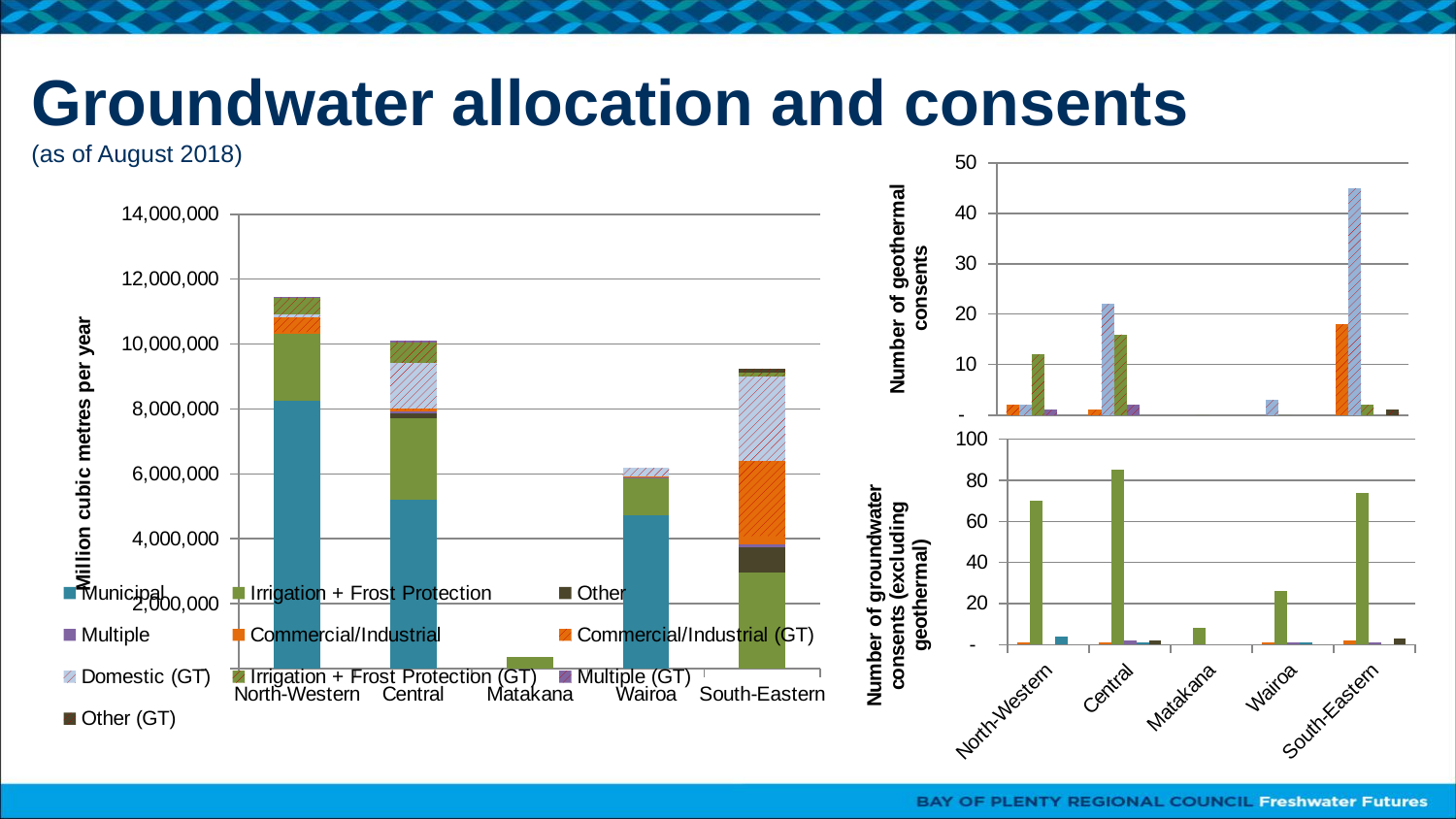
In the large chart on the left, which region has the tallest stacked bar? North-Western How many series does the legend of the large chart on the left list? 10 What kind of chart is the large chart on the left of the slide? bar chart In the large chart on the left, which region has the shortest stacked bar? Matakana In the large chart on the left, is the Municipal value for North-Western greater or less than 6,000,000? greater In the 'Number of groundwater consents (excluding geothermal)' chart, which region has the tallest bar? Central How many regions are shown on the x axis of the large chart on the left? 5 In the large chart on the left, is the total stacked bar for South-Eastern greater or less than 8,000,000? greater In the large chart on the left, which region has the larger total stacked bar, Wairoa or Central? Central In the 'Number of geothermal consents' chart, is the Domestic (GT) value for South-Eastern greater or less than 40? greater